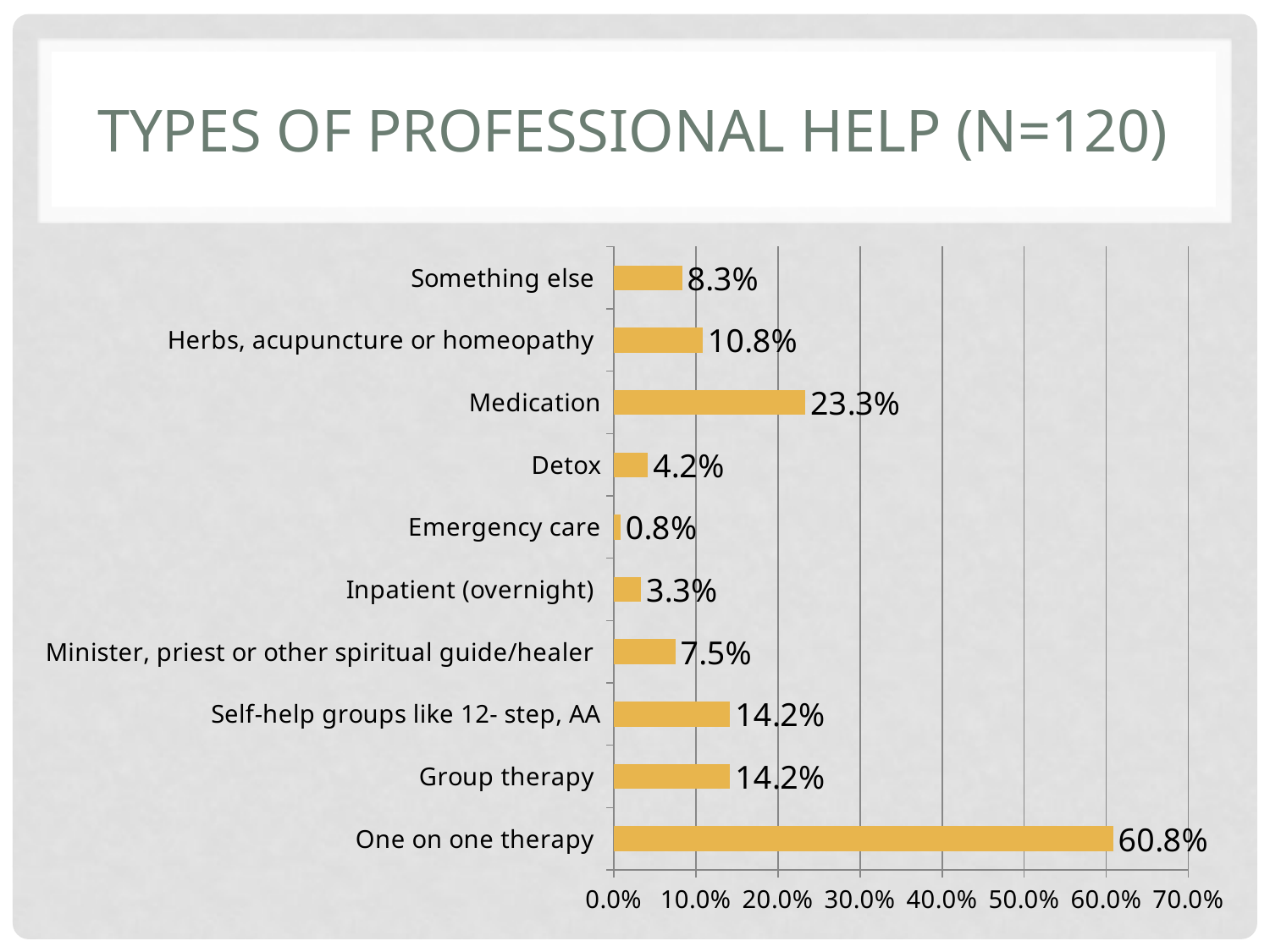
Which type of professional help has the lowest value? Emergency care What is the value for Herbs, acupuncture or homeopathy? 10.8% What is the difference between the values for One on one therapy and Medication? 37.5% How many categories are shown in the chart? 10 What kind of chart is shown on the slide? Bar chart Which is larger, the value for Medication or the value for Self-help groups like 12- step, AA? Medication What is the difference between the values for Something else and Detox? 4.1% Which type of professional help has the highest value? One on one therapy What is the value for One on one therapy? 60.8% Is the value for One on one therapy greater or less than 50.0%? greater What is the value for Medication? 23.3% What is the value for Emergency care? 0.8%